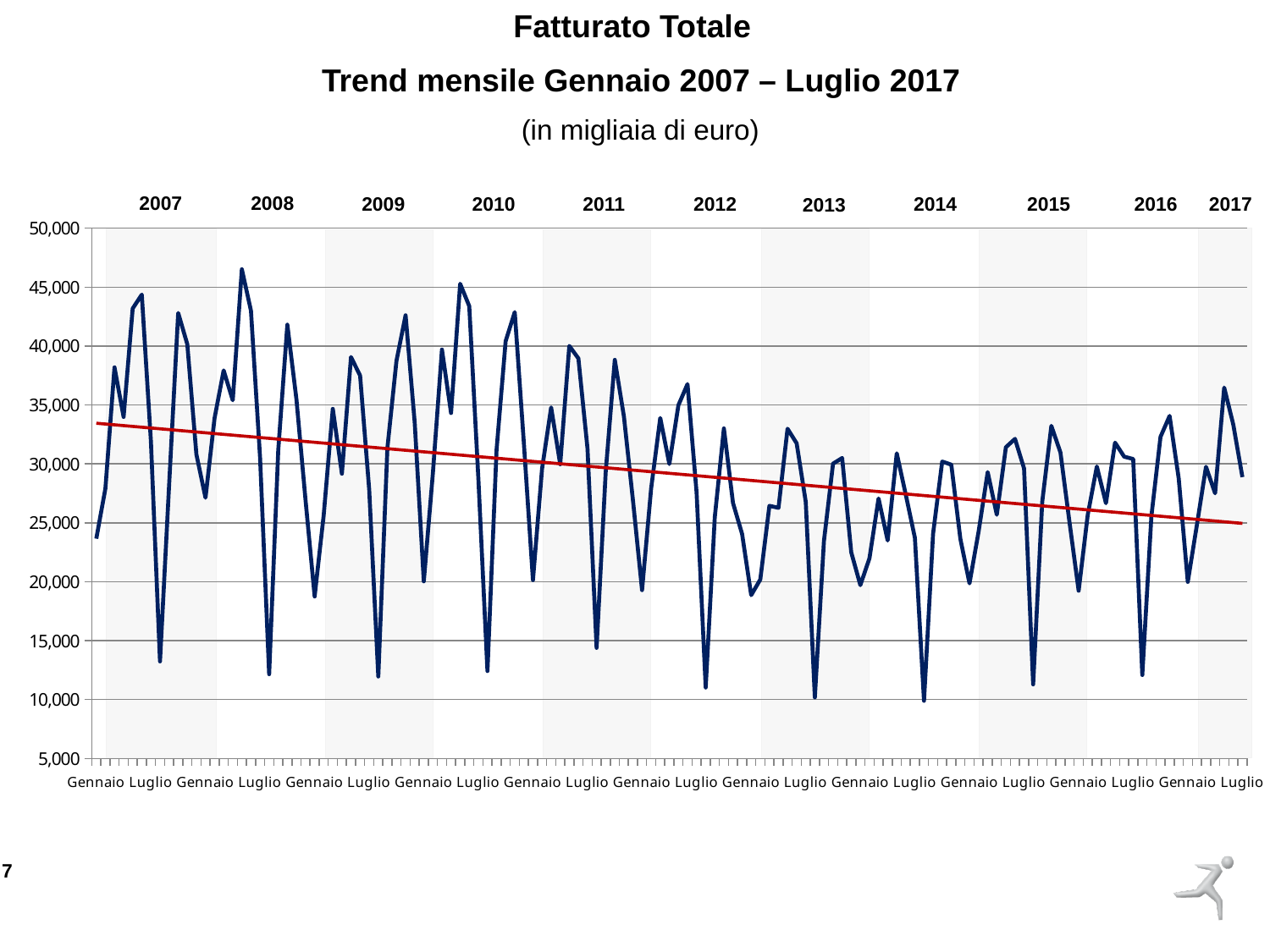
How many years are labelled along the top of the chart? 11 Is the highest peak of the blue line in 2008 greater or less than 45,000? greater Is the highest peak of the blue line in 2017 greater or less than 35,000? greater Is the value of the red trend line at the start of 2007 greater or less than 30,000? greater What is the title of the chart? Fatturato Totale – Trend mensile Gennaio 2007 – Luglio 2017 Does the red trend line rise or fall from 2007 to 2017? fall What is the highest value shown on the vertical axis? 50,000 What kind of chart is shown on the slide? line chart In which year does the blue line reach its highest peak? 2008 In what unit are the values on the chart expressed? in migliaia di euro